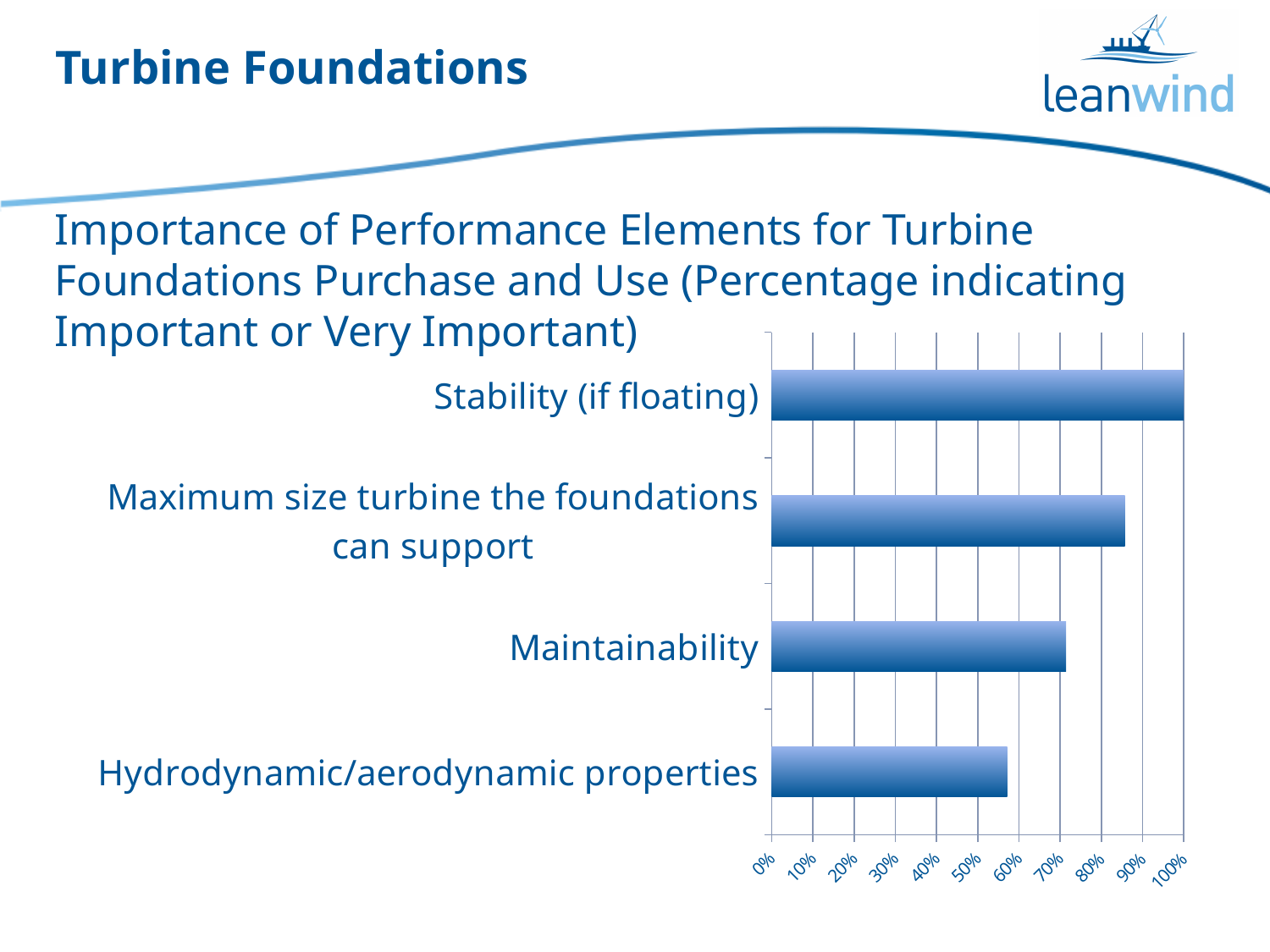
What is the value for Stability (if floating)? 100% What is the maximum value shown on the horizontal axis of the chart? 100% Is the value for Maintainability greater or less than 80%? less Which category has the highest value in the chart? Stability (if floating) What type of chart is shown on the slide? bar chart Is the value for Hydrodynamic/aerodynamic properties greater or less than 60%? less Is the value for Maximum size turbine the foundations can support greater or less than 80%? greater Which category has the lowest value in the chart? Hydrodynamic/aerodynamic properties How many categories are plotted in the chart? 4 Which is larger, the value for Maximum size turbine the foundations can support or the value for Maintainability? Maximum size turbine the foundations can support Which is larger, the value for Maintainability or the value for Hydrodynamic/aerodynamic properties? Maintainability